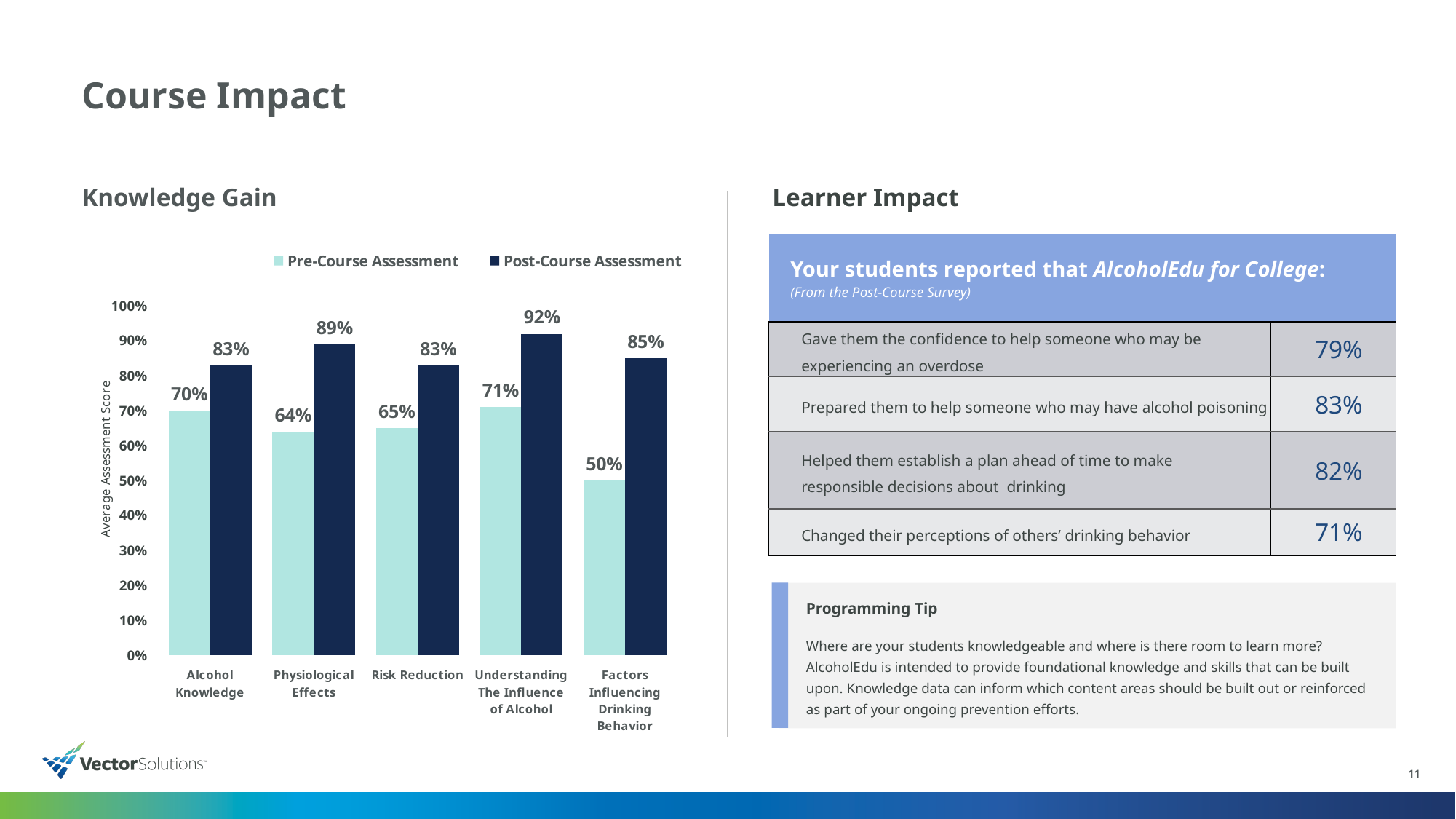
What kind of chart is shown under Knowledge Gain? Bar chart Which is larger: the Pre-Course Assessment value for Alcohol Knowledge or for Physiological Effects? Alcohol Knowledge What is the Pre-Course Assessment value for Alcohol Knowledge? 70% What is the Post-Course Assessment value for Physiological Effects? 89% Which category has the lowest Pre-Course Assessment value? Factors Influencing Drinking Behavior How many series does the legend list? 2 Which category has the highest Post-Course Assessment value? Understanding The Influence of Alcohol What is the Pre-Course Assessment value for Factors Influencing Drinking Behavior? 50% What is the label of the y axis of the chart? Average Assessment Score What is the difference between the Post-Course and Pre-Course Assessment values for Factors Influencing Drinking Behavior? 35% What is the difference between the Post-Course and Pre-Course Assessment values for Risk Reduction? 18% How many categories are shown on the x axis of the chart? 5